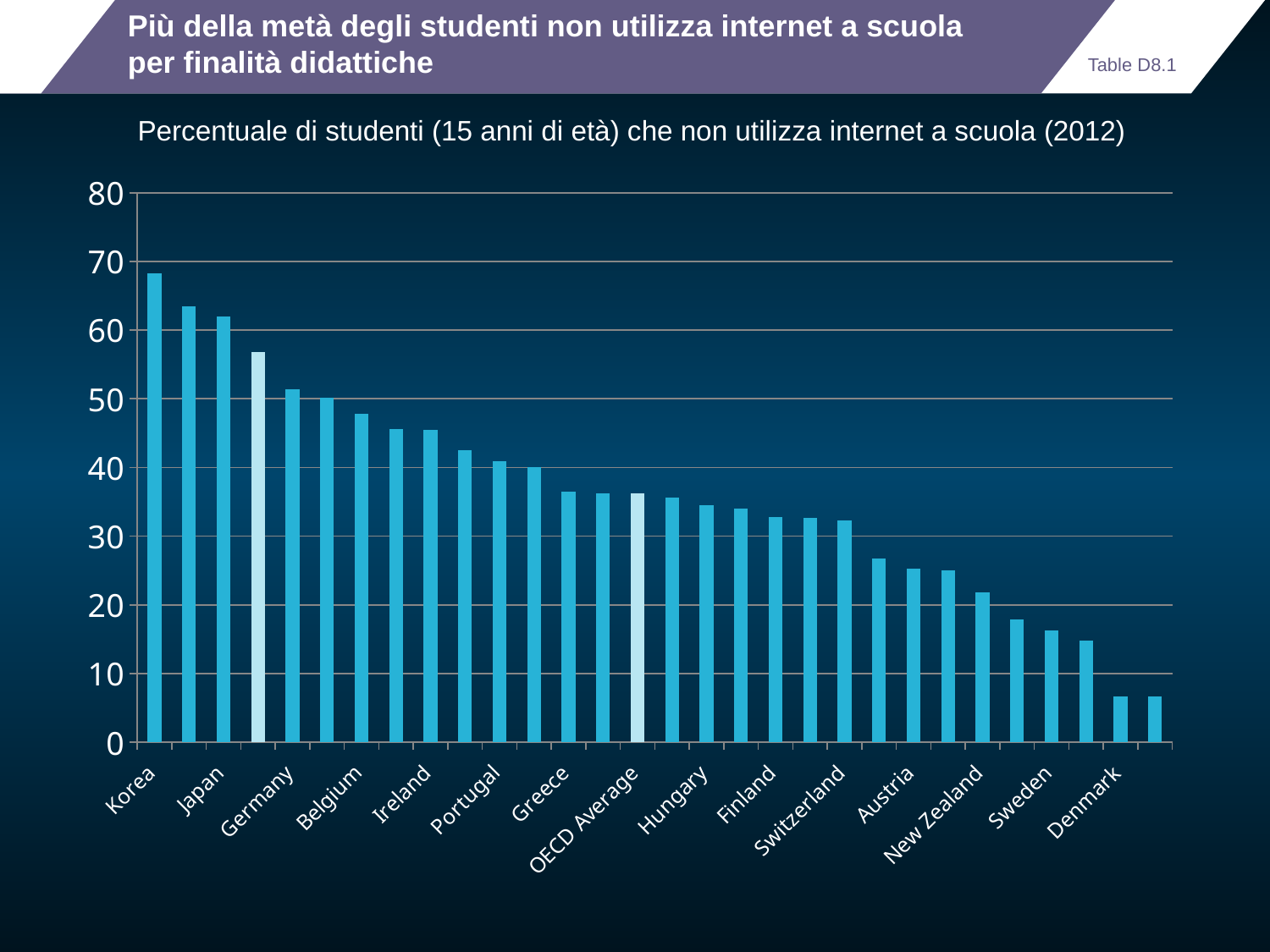
Is the value for OECD Average greater or less than 40? less Is the value for Korea greater or less than 60? greater Is the value for Denmark greater or less than 10? less Which has a higher value, Austria or Sweden? Austria What is the title of the chart? Percentuale di studenti (15 anni di età) che non utilizza internet a scuola (2012) Which has a higher value, Korea or Japan? Korea What kind of chart is shown on the slide? bar chart Which country has the highest percentage of students not using internet at school? Korea Do the values rise or fall from left to right along the x axis? fall